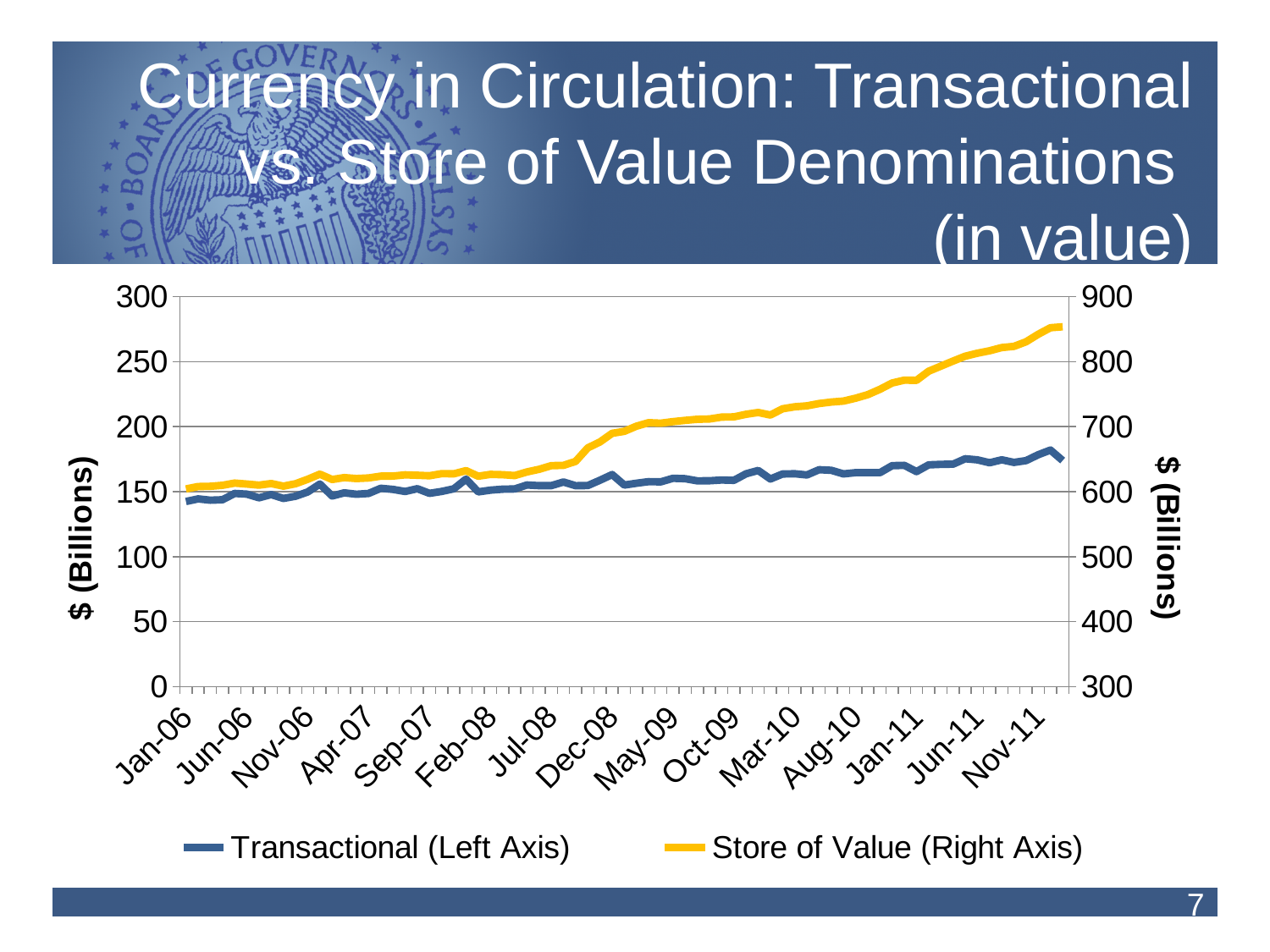
Does the Transactional series generally rise or fall over the period shown? Rise What kind of chart is shown on the slide? Line chart How many date labels are shown along the x axis? 15 Does the Store of Value series rise or fall from Jan-06 to Nov-11? Rise Is the Store of Value value at Nov-11 greater or less than 800 on the right axis? greater How many series does the legend list? 2 Is the Transactional value at Nov-11 greater or less than 150 on the left axis? greater What is the title of the chart on the slide? Currency in Circulation: Transactional vs. Store of Value Denominations (in value) Is the Store of Value value at Jan-11 greater or less than 700 on the right axis? greater What are the two series named in the legend? Transactional (Left Axis) and Store of Value (Right Axis)